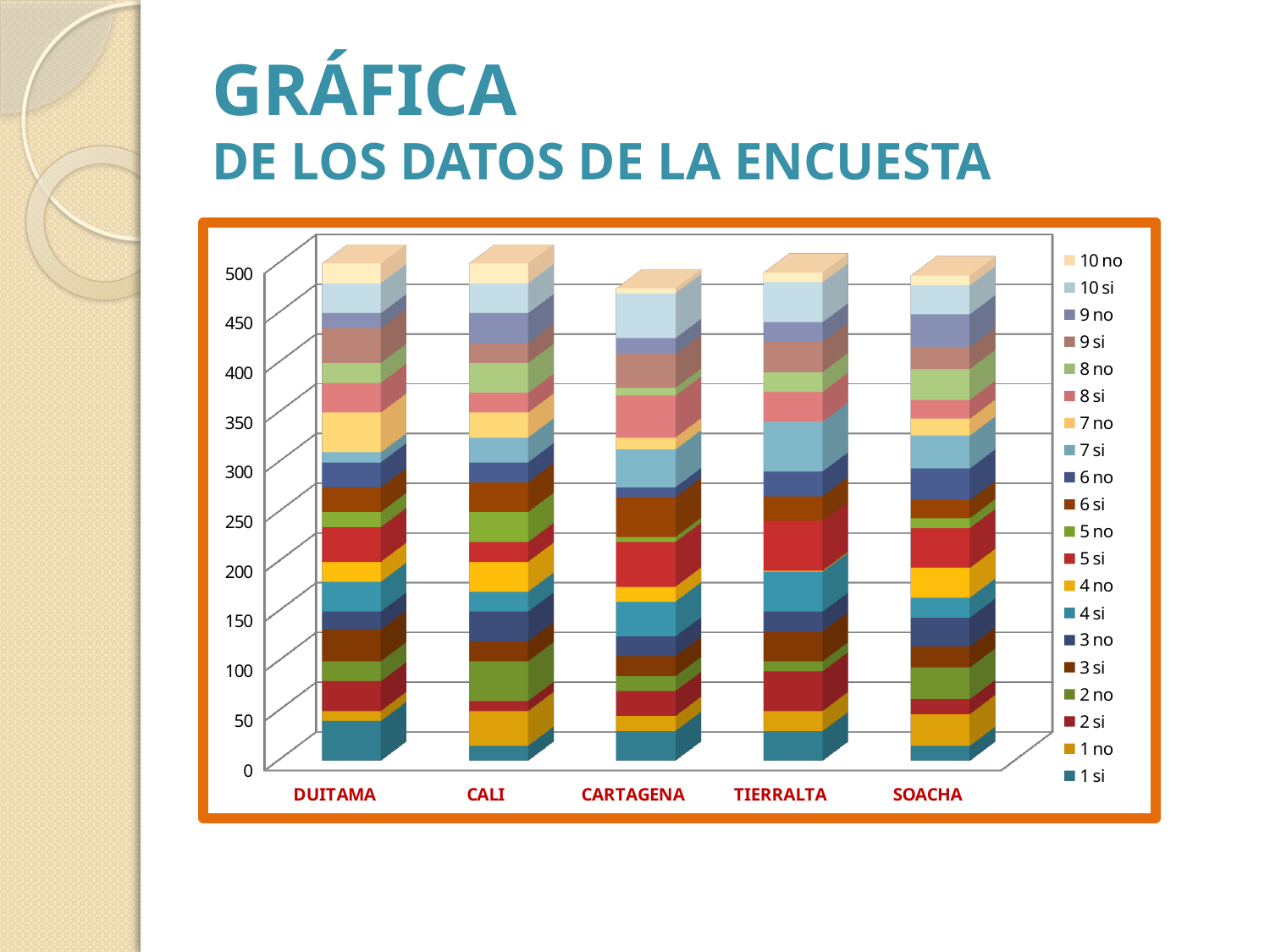
Which is larger, the total stacked bar for CALI or for CARTAGENA? CALI Is the total stacked value for DUITAMA greater or less than 400? greater Which category label appears first (leftmost) on the x axis? DUITAMA What kind of chart is shown on the slide? Stacked bar chart How many series does the chart's legend list? 20 Is the total stacked value for CARTAGENA greater or less than 400? greater How many cities (categories) are shown on the x axis of the chart? 5 Which city has the lowest total stacked bar? CARTAGENA What is the title of the slide containing the chart? GRÁFICA DE LOS DATOS DE LA ENCUESTA What is the highest value shown on the vertical axis of the chart? 500 Is the total stacked value for SOACHA greater or less than 300? greater